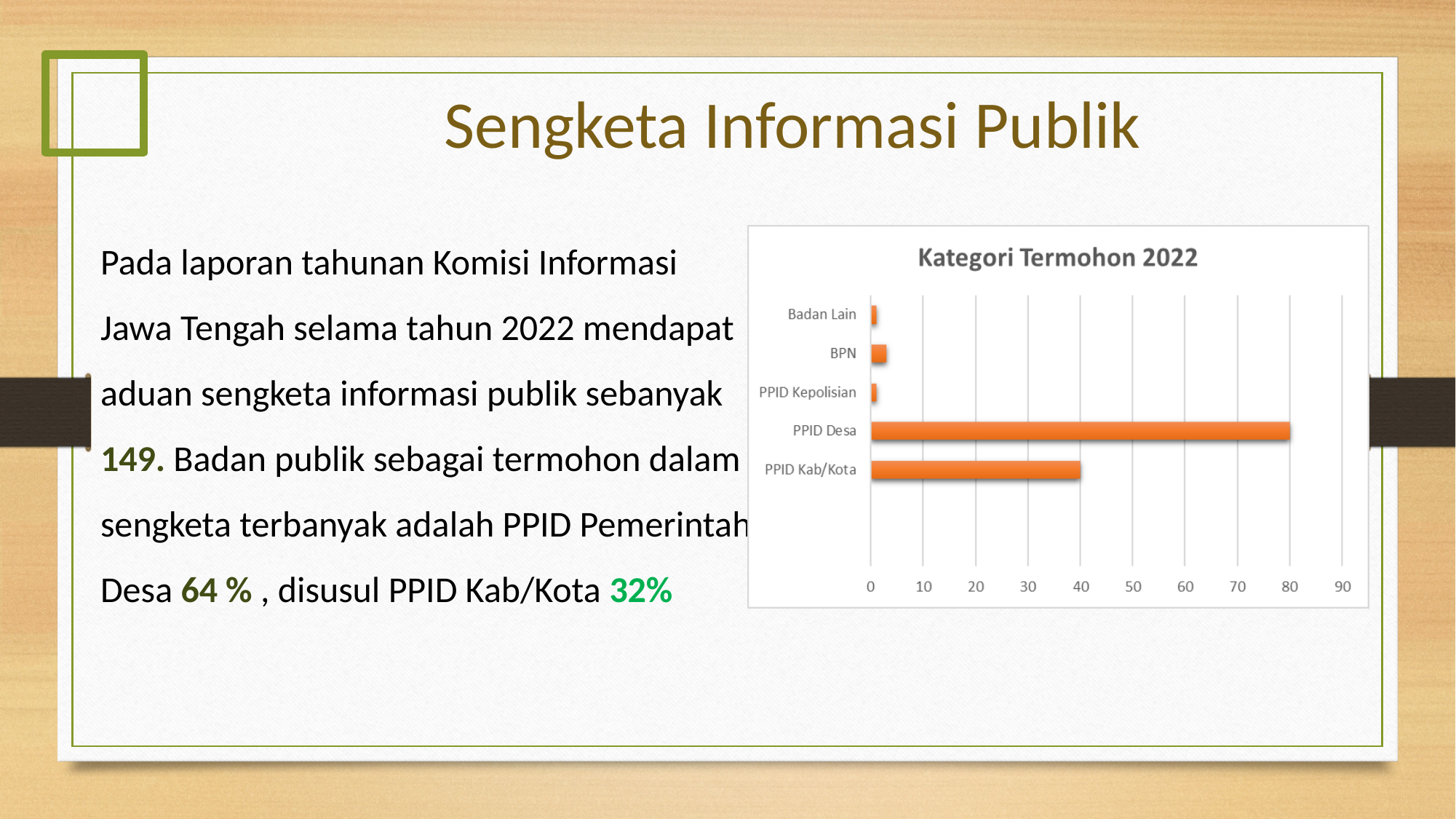
Which is larger, the value for PPID Desa or the value for PPID Kab/Kota? PPID Desa How many categories are shown in the chart? 5 Is the value for BPN greater or less than 10? less Is the value for PPID Desa greater or less than 70? greater Which is larger, the value for BPN or the value for Badan Lain? BPN What kind of chart is shown on the slide? bar chart Is the value for PPID Kab/Kota greater or less than 30? greater Which category has the highest value in the chart? PPID Desa What is the title of the chart? Kategori Termohon 2022 What is the highest tick value shown on the horizontal axis of the chart? 90